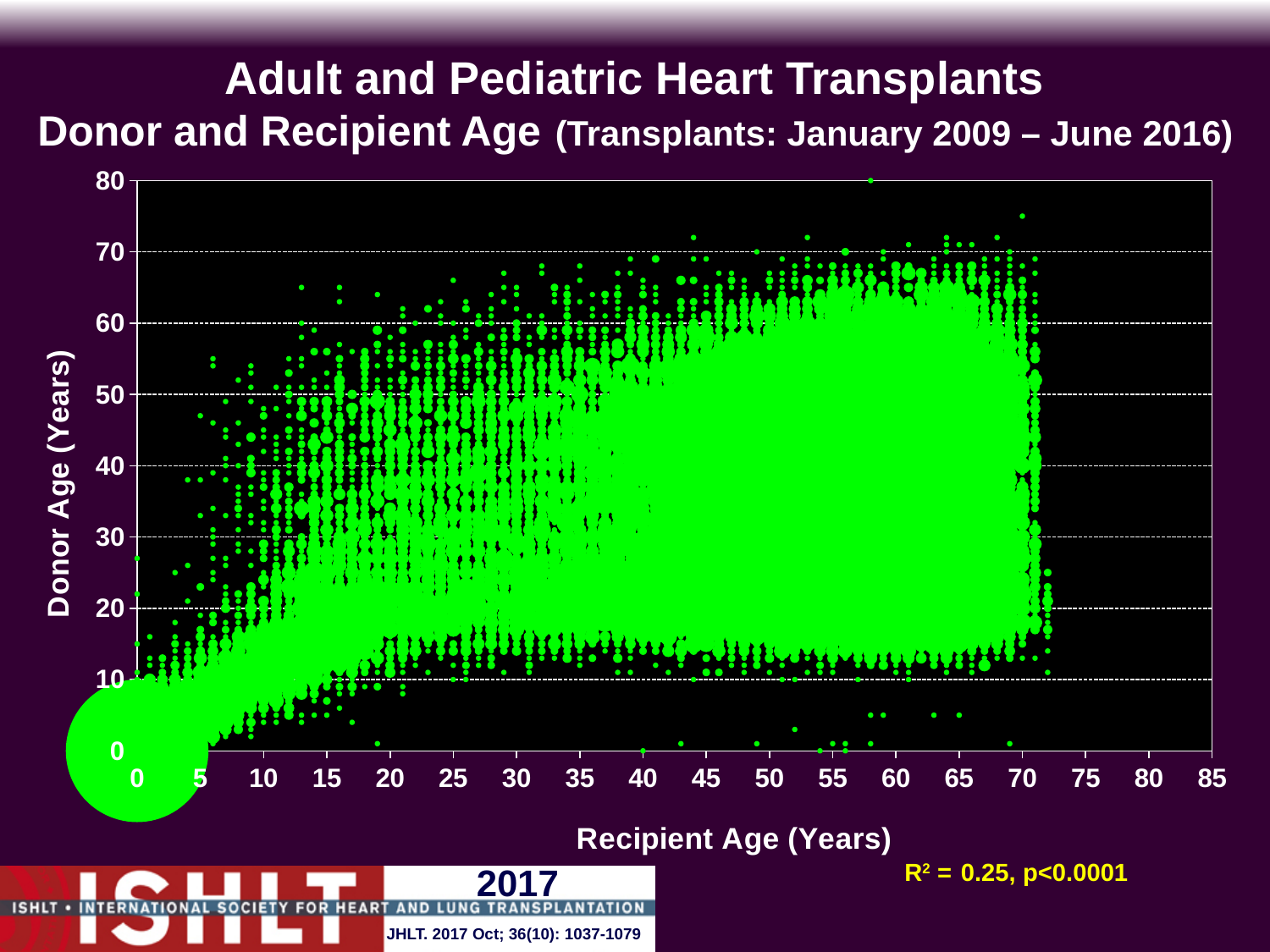
What is the label of the x axis? Recipient Age (Years) What is the title of the chart? Adult and Pediatric Heart Transplants Donor and Recipient Age What is the highest tick value shown on the x axis? 85 Is the largest recipient age plotted greater or less than 75 years? less What transplant date range does the chart cover? January 2009 – June 2016 What p-value is reported on the chart? p<0.0001 What kind of chart is shown on the slide? Scatter (bubble) chart Is the largest donor age plotted greater or less than 70 years? greater What is the highest tick value shown on the y axis? 80 What R² value is reported on the chart? R² = 0.25